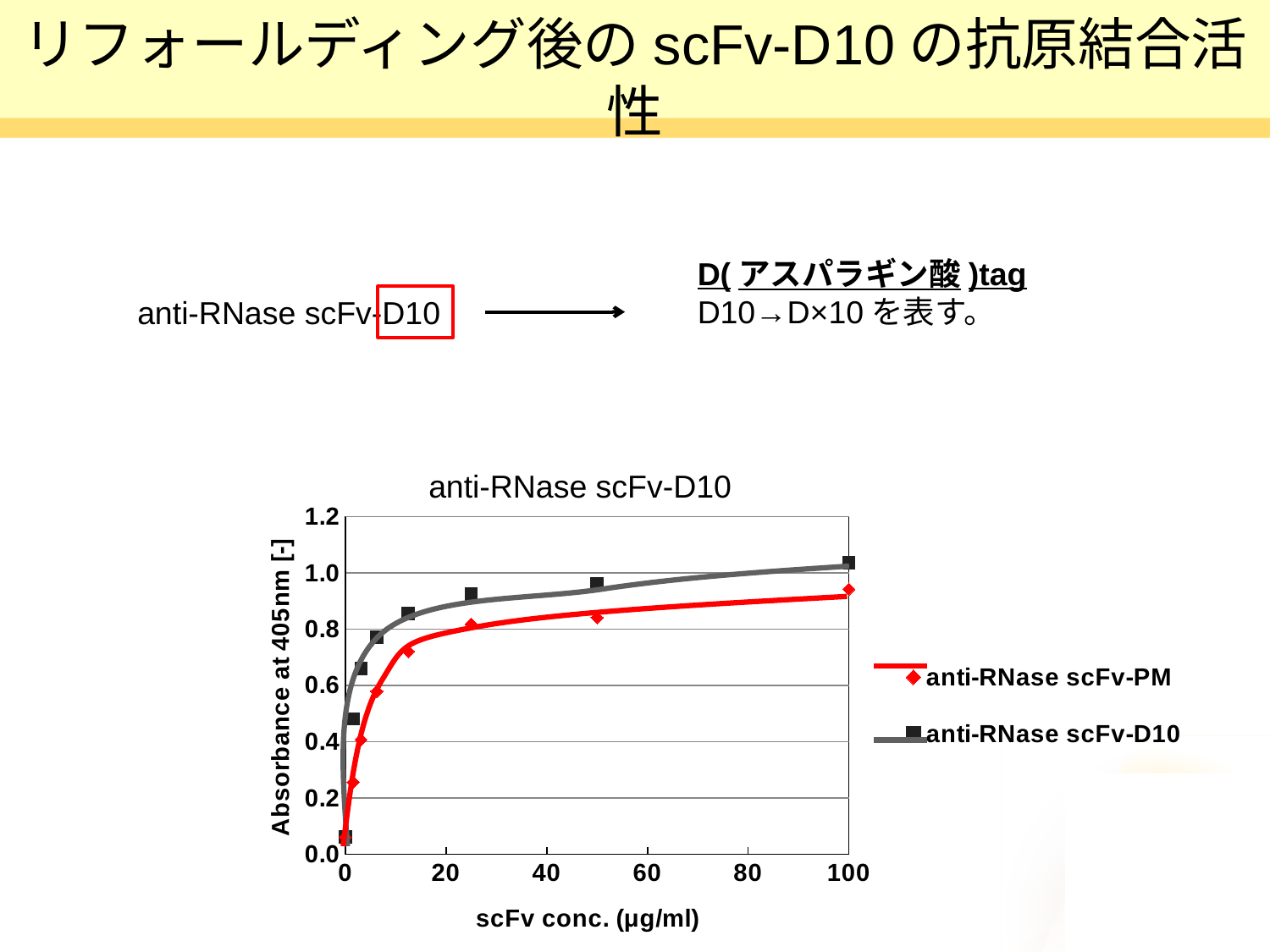
Is the absorbance for anti-RNase scFv-PM at 100 µg/ml greater or less than 1.0? less Which series has the higher absorbance at 50 µg/ml? anti-RNase scFv-D10 What is the label of the y axis of the chart? Absorbance at 405nm [-] How many series does the chart legend list? 2 Is the absorbance for anti-RNase scFv-D10 at 25 µg/ml greater or less than 0.8? greater What is the title of the chart? anti-RNase scFv-D10 Is the absorbance for anti-RNase scFv-PM at about 12.5 µg/ml greater or less than 0.8? less What kind of chart is shown on the slide? Line chart with markers (scatter plot) At 100 µg/ml, which series has the higher absorbance, anti-RNase scFv-PM or anti-RNase scFv-D10? anti-RNase scFv-D10 Does the absorbance for anti-RNase scFv-D10 rise or fall as scFv concentration increases? rise